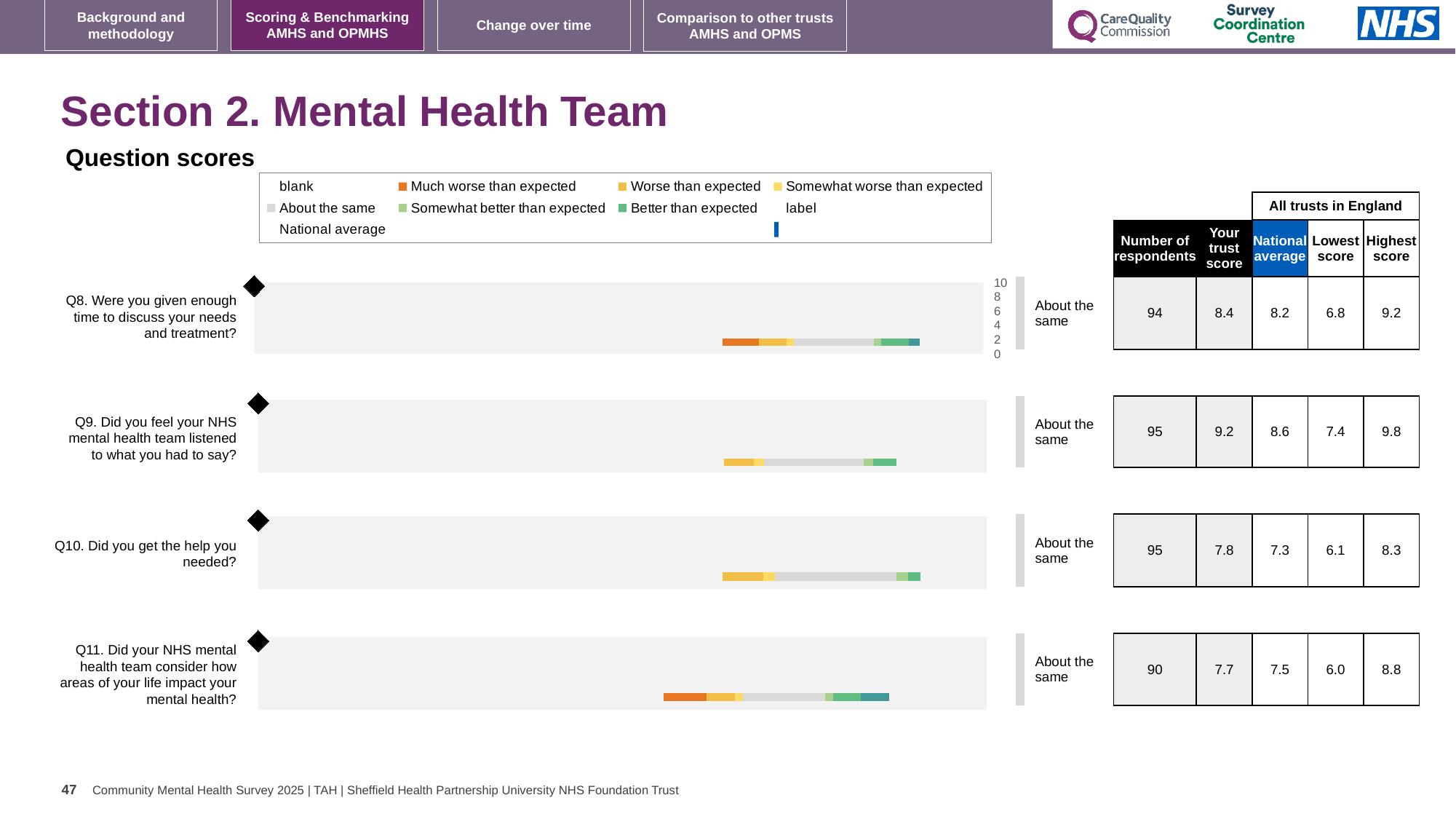
Which question (Q8 to Q11) has the lowest 'Your trust score' in the table? Q11 In the table next to the Q9 chart, what is the 'Your trust score' value? 9.2 In the table next to the Q11 chart, how many respondents are listed? 90 For Q8, what is the difference between 'Your trust score' and the national average in the table? 0.2 What benchmark category label is shown to the right of the Q8 chart? About the same For Q9, which is larger in the table: 'Your trust score' or the national average? Your trust score How many question charts (Q8 to Q11) are shown on the slide? 4 In the table next to the Q11 chart, what is the highest score among all trusts in England? 8.8 What kind of chart is used to show the Q8 question score? bar chart Which question (Q8 to Q11) has the highest 'Your trust score' in the table? Q9 In the table next to the Q10 chart, what is the national average? 7.3 For Q10, what is the difference between the highest score and the lowest score in the table? 2.2